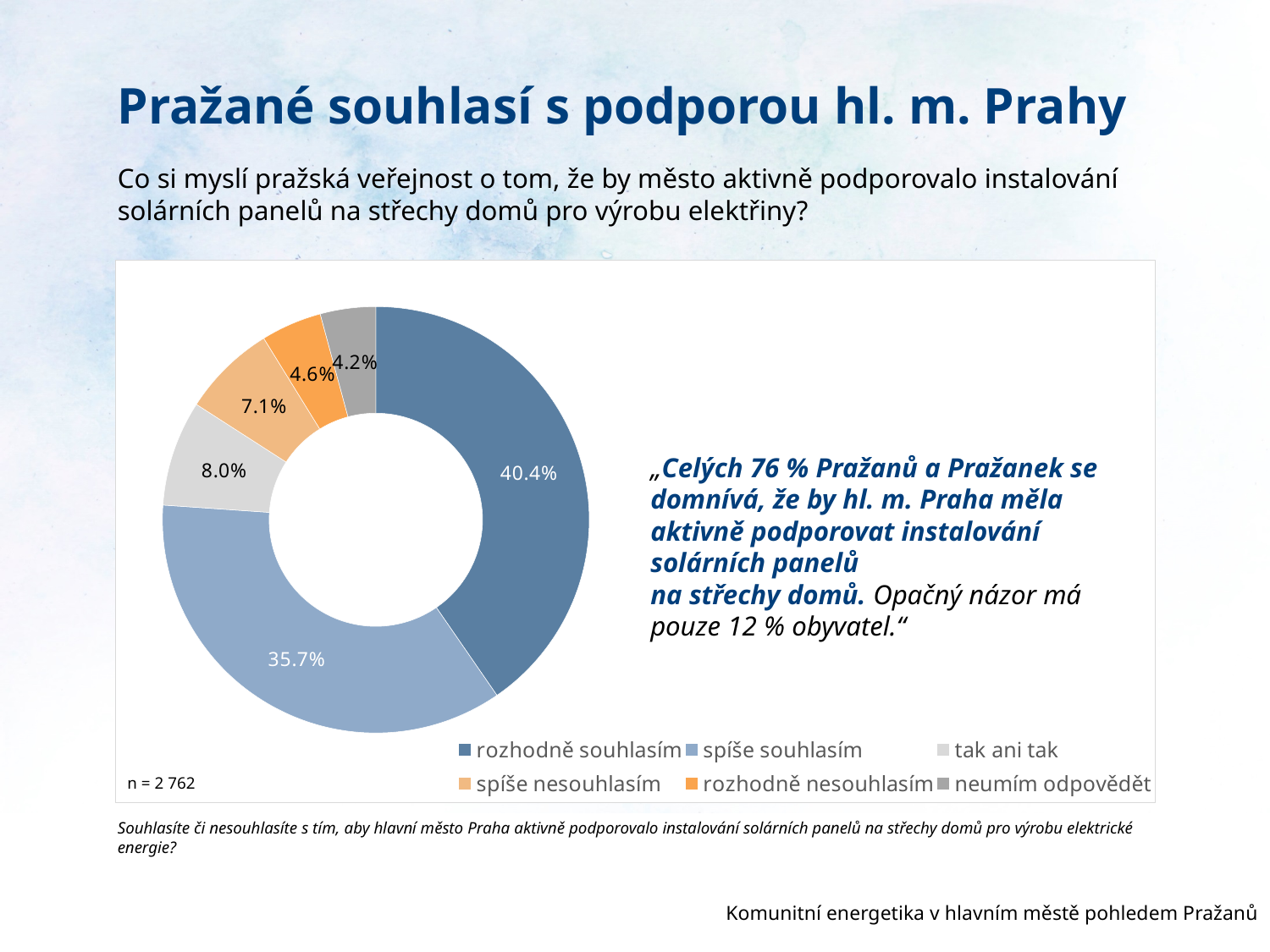
What percentage is shown for "spíše nesouhlasím"? 7.1% What sample size (n) is stated on the chart? n = 2 762 What share of the chart is "tak ani tak"? 8.0% Which is larger, the share for "spíše nesouhlasím" or for "rozhodně nesouhlasím"? spíše nesouhlasím What percentage is shown for "neumím odpovědět"? 4.2% What percentage of respondents answered "rozhodně souhlasím"? 40.4% Which response category has the smallest share of the chart? neumím odpovědět How many response categories does the chart show? 6 What is the difference in percentage points between "rozhodně souhlasím" and "spíše souhlasím"? 4.7 percentage points What percentage of respondents answered "spíše souhlasím"? 35.7% What kind of chart is shown on the slide? Doughnut (pie) chart Which response category has the largest share of the chart? rozhodně souhlasím